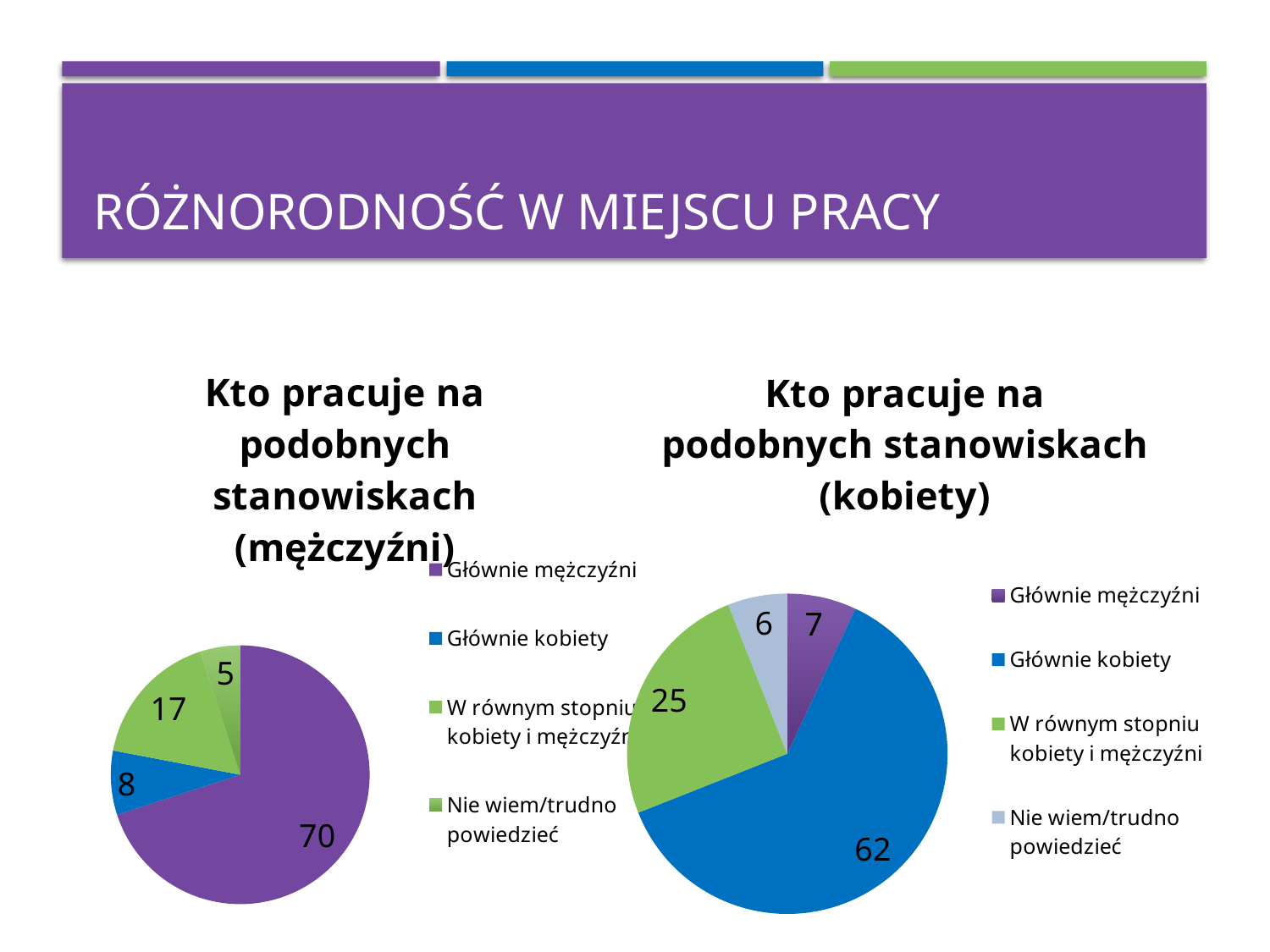
In the chart 'Kto pracuje na podobnych stanowiskach (mężczyźni)', what is the value for 'Głównie mężczyźni'? 70 In the chart 'Kto pracuje na podobnych stanowiskach (mężczyźni)', which category has the largest slice? Głównie mężczyźni In the chart 'Kto pracuje na podobnych stanowiskach (mężczyźni)', what is the value for 'W równym stopniu kobiety i mężczyźni'? 17 In the chart 'Kto pracuje na podobnych stanowiskach (kobiety)', which is larger: 'W równym stopniu kobiety i mężczyźni' or 'Głównie mężczyźni'? W równym stopniu kobiety i mężczyźni In the chart 'Kto pracuje na podobnych stanowiskach (kobiety)', which category has the smallest slice? Nie wiem/trudno powiedzieć How many charts are shown on the slide? 2 What kind of chart is 'Kto pracuje na podobnych stanowiskach (mężczyźni)'? Pie chart How many categories does the chart 'Kto pracuje na podobnych stanowiskach (kobiety)' show? 4 In the chart 'Kto pracuje na podobnych stanowiskach (kobiety)', what is the value for 'Głównie kobiety'? 62 In the chart 'Kto pracuje na podobnych stanowiskach (kobiety)', what share of the pie does 'Głównie kobiety' represent? 62% In the chart 'Kto pracuje na podobnych stanowiskach (mężczyźni)', what is the difference between the values for 'Głównie mężczyźni' and 'Głównie kobiety'? 62 In the chart 'Kto pracuje na podobnych stanowiskach (kobiety)', what is the value for 'Nie wiem/trudno powiedzieć'? 6